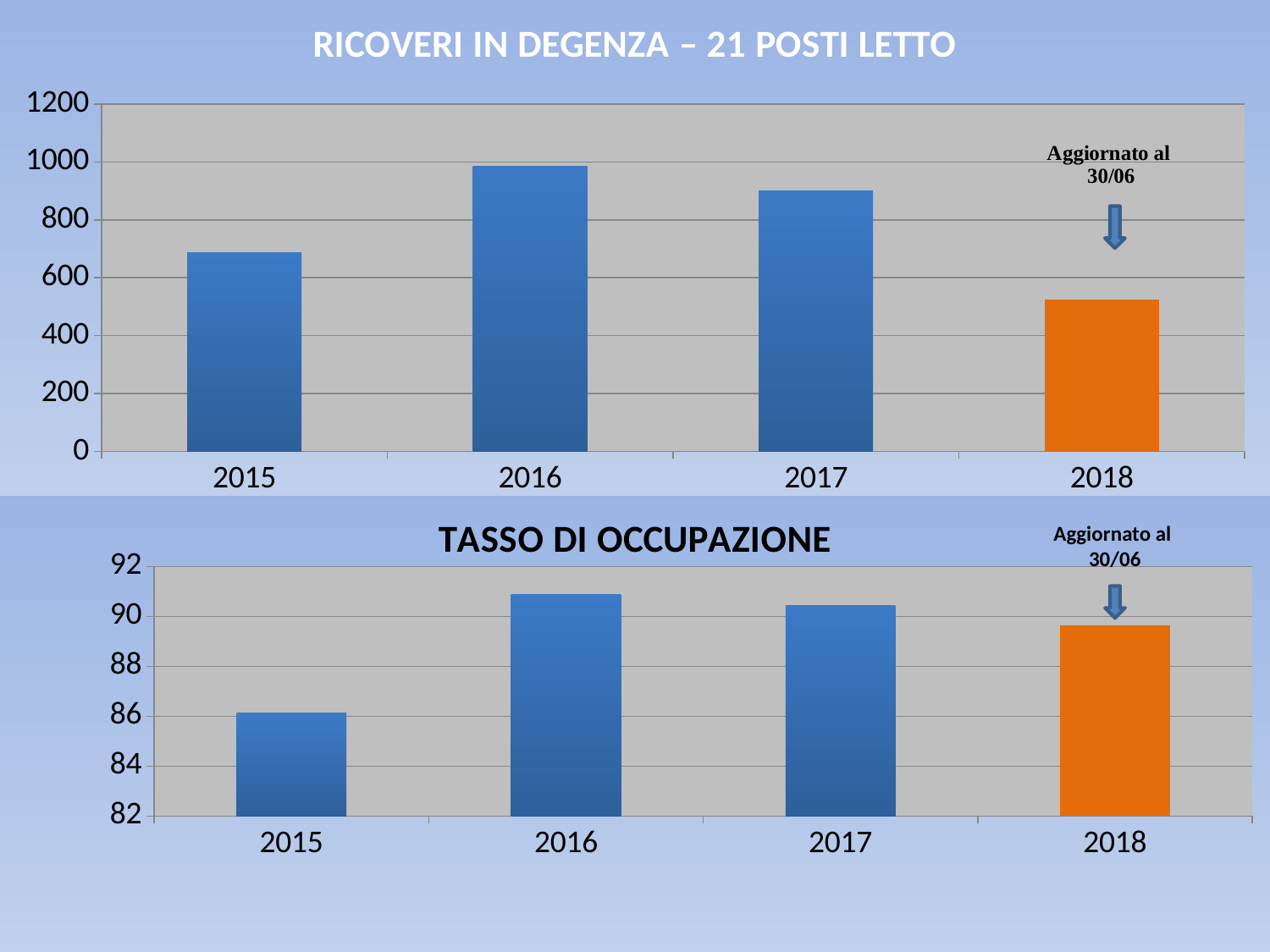
In the top chart 'RICOVERI IN DEGENZA – 21 POSTI LETTO', how many years are shown on the x axis? 4 In the top chart 'RICOVERI IN DEGENZA – 21 POSTI LETTO', which year has the lowest bar? 2018 In the top chart 'RICOVERI IN DEGENZA – 21 POSTI LETTO', is the value for 2015 greater or less than 600? greater In the bottom chart 'TASSO DI OCCUPAZIONE', which year has the lowest bar? 2015 In the top chart 'RICOVERI IN DEGENZA – 21 POSTI LETTO', is the value for 2016 greater or less than 1000? less In the top chart 'RICOVERI IN DEGENZA – 21 POSTI LETTO', which year has the highest bar? 2016 In the top chart 'RICOVERI IN DEGENZA – 21 POSTI LETTO', what kind of chart is shown? Bar chart In the bottom chart 'TASSO DI OCCUPAZIONE', is the value for 2015 greater or less than 88? less In the bottom chart 'TASSO DI OCCUPAZIONE', what note is written above the 2018 bar? Aggiornato al 30/06 In the top chart 'RICOVERI IN DEGENZA – 21 POSTI LETTO', which is larger, the value for 2017 or the value for 2015? 2017 In the top chart 'RICOVERI IN DEGENZA – 21 POSTI LETTO', what colour is the bar for 2018? Orange